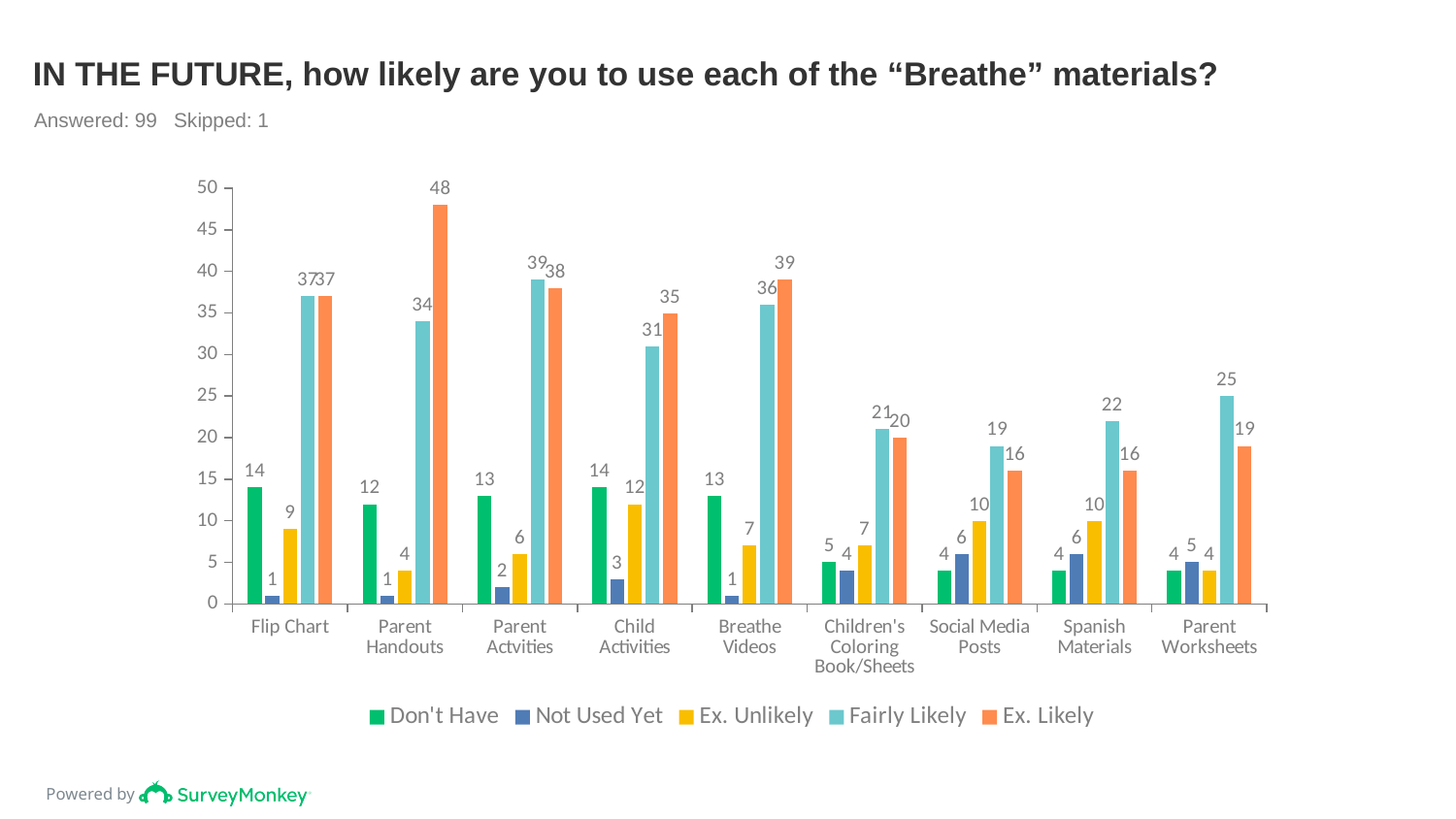
What is the value for Don't Have for Flip Chart? 14 How many series does the legend list? 5 What kind of chart is shown on the slide? Bar chart What is the value for Ex. Likely for Parent Handouts? 48 How many respondents answered the question according to the slide? 99 How many categories are shown on the x axis? 9 Which is larger for Child Activities: Fairly Likely or Ex. Likely? Ex. Likely What is the difference between the Ex. Likely and Fairly Likely values for Parent Handouts? 14 Which category has the highest Ex. Likely value? Parent Handouts What is the value for Fairly Likely for Parent Worksheets? 25 Which category has the lowest Fairly Likely value? Social Media Posts What is the value for Ex. Unlikely for Social Media Posts? 10